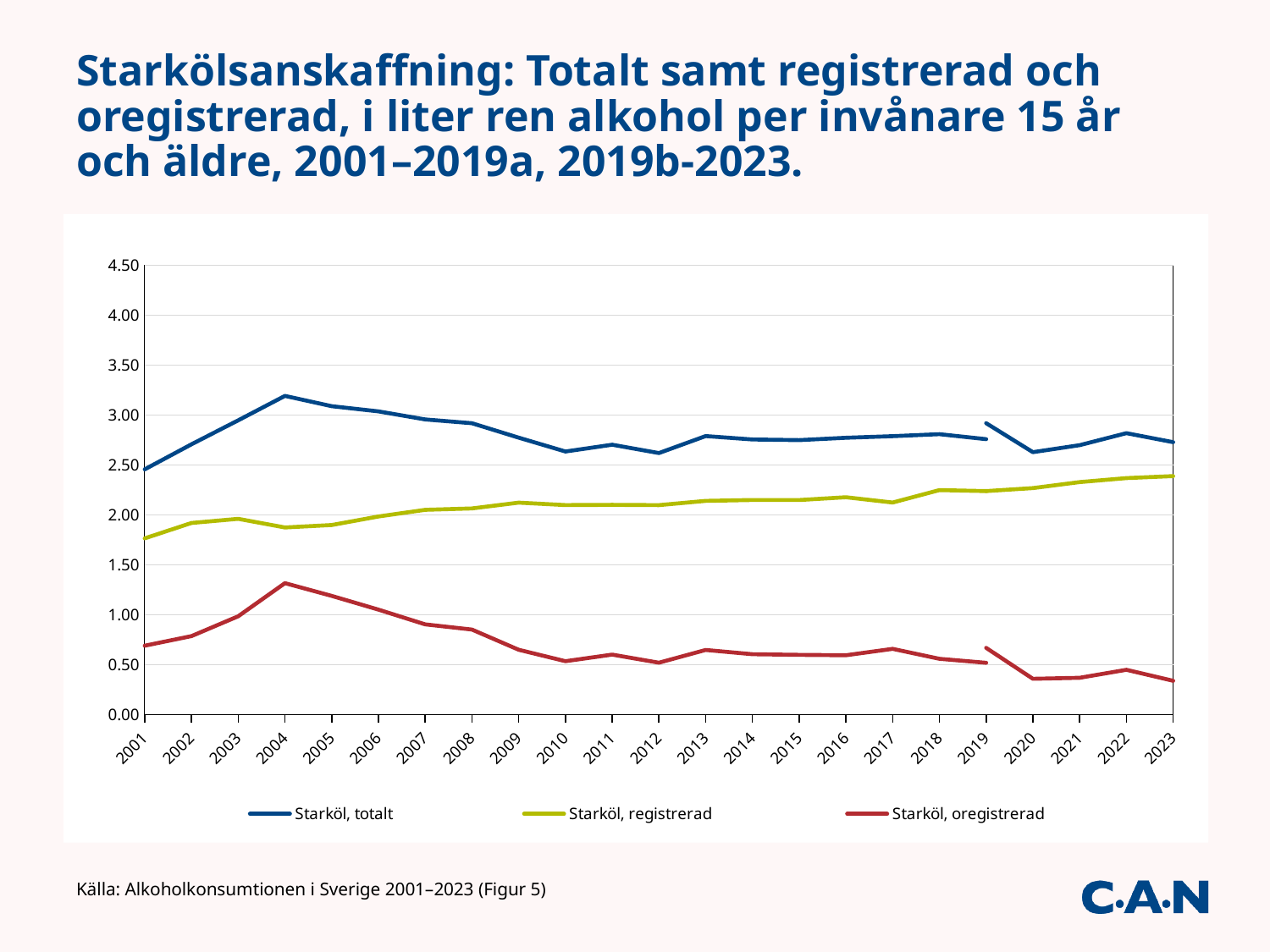
How many series does the legend list? 3 Is the value for 'Starköl, oregistrerad' in 2023 greater or less than 0.50? less Is the value for 'Starköl, registrerad' in 2001 greater or less than 2.00? less Does the 'Starköl, oregistrerad' series generally rise or fall from 2004 to 2023? Fall Which series is drawn in dark blue? Starköl, totalt In which year is the 'Starköl, registrerad' series at its lowest? 2001 Which is larger for 'Starköl, registrerad': the value in 2001 or the value in 2023? 2023 What kind of chart is shown on the slide? Line chart In which year does the 'Starköl, oregistrerad' series peak? 2004 In which year does the 'Starköl, totalt' series reach its highest value? 2004 How many years are labelled on the x axis? 23 Is the value for 'Starköl, totalt' in 2004 greater or less than 3.00? greater